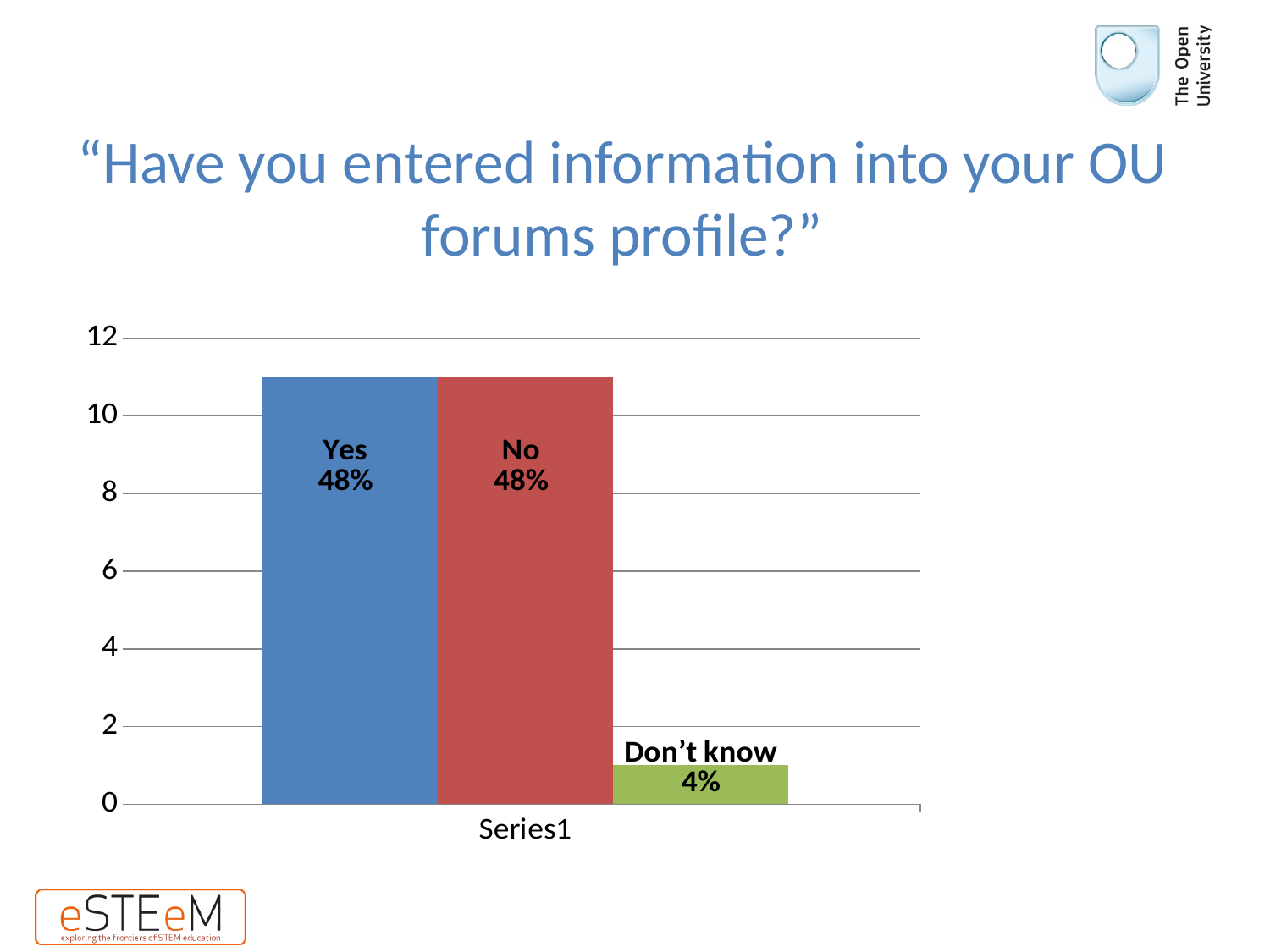
What colour is the "Don't know" bar? Green What percentage is shown for the "Don't know" bar? 4% How many bars are plotted in the chart? 3 What percentage is shown for the "Yes" bar? 48% What is the title of the slide above the chart? "Have you entered information into your OU forums profile?" Which response has the lowest value? Don't know What kind of chart is shown on the slide? Bar chart Which is larger, the value for "Yes" or the value for "Don't know"? Yes Is the bar for "Yes" greater or less than 10 on the vertical axis? greater What is the difference in percentage points between "No" and "Don't know"? 44% What percentage is shown for the "No" bar? 48% Is the bar for "Don't know" greater or less than 2 on the vertical axis? less